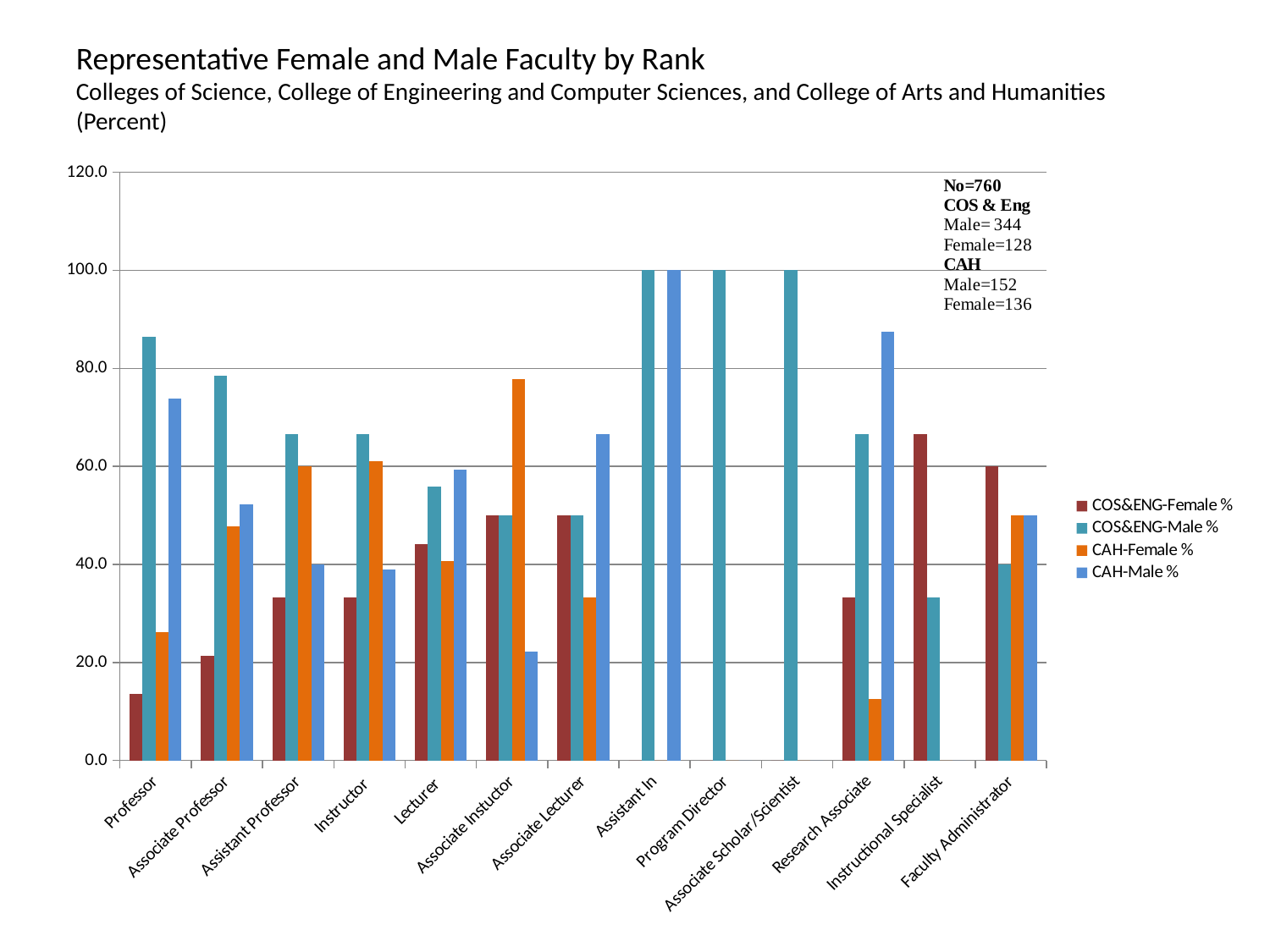
What is the CAH-Male % value for Assistant In? 100.0 What kind of chart is shown on the slide? bar chart Is the COS&ENG-Male % value for Professor greater or less than 80.0? greater How many faculty rank categories are shown on the x axis? 13 Which series is shown in orange in the legend? CAH-Female % What is the COS&ENG-Male % value for Associate Scholar/Scientist? 100.0 Is the COS&ENG-Female % value for Professor greater or less than 20.0? less Is the CAH-Female % value for Associate Instuctor greater or less than 60.0? greater What is the COS&ENG-Male % value for Program Director? 100.0 For Research Associate, which series has the lowest value? CAH-Female % For Professor, which is larger: the COS&ENG-Male % value or the CAH-Male % value? COS&ENG-Male % How many series does the legend list? 4